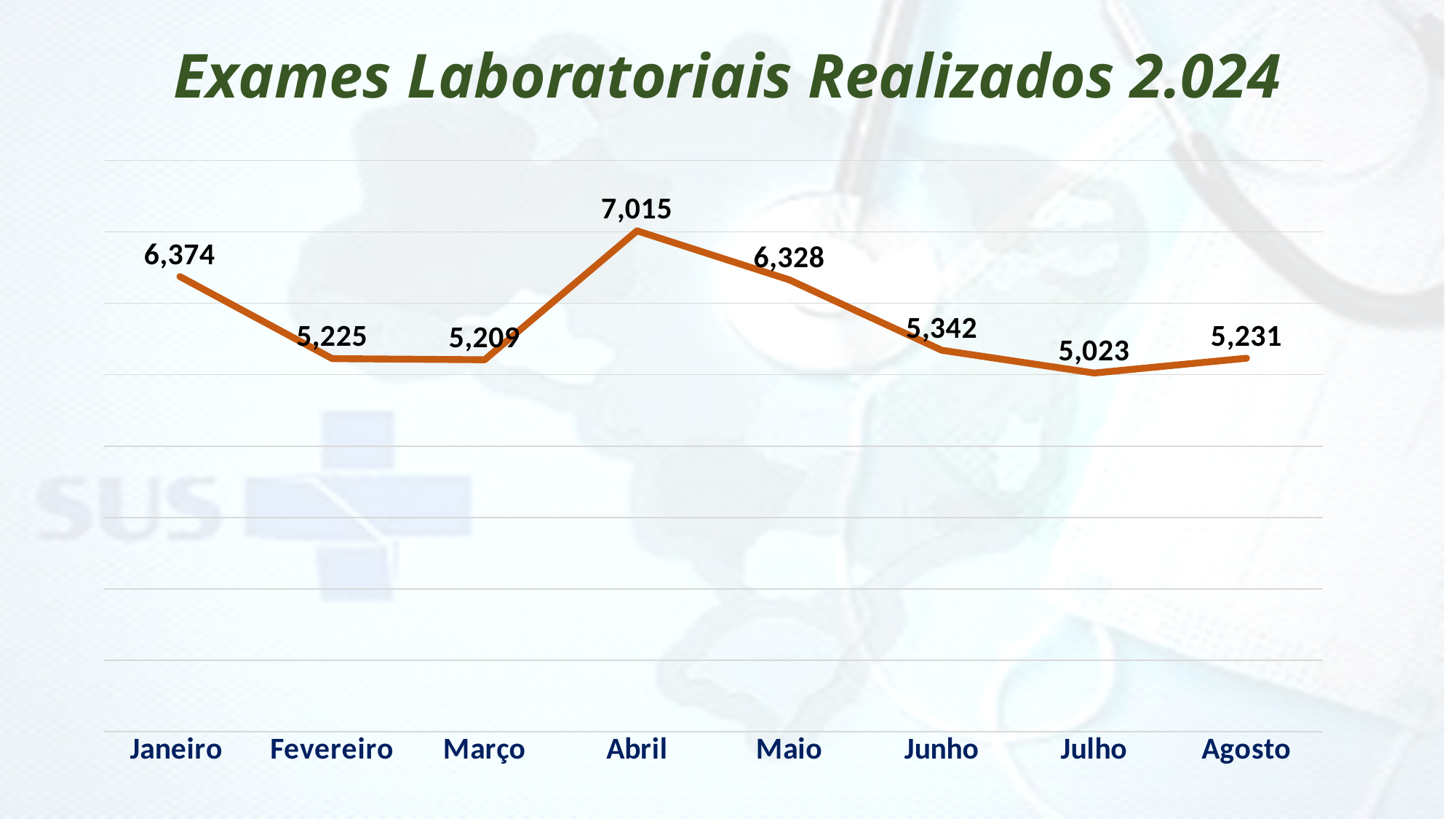
What is the value for Abril? 7,015 Which month has the highest value? Abril How many months are plotted on the chart? 8 What is the value for Janeiro? 6,374 Do the values rise or fall from Abril to Julho? Fall What is the title of the chart? Exames Laboratoriais Realizados 2.024 What is the difference between the values for Abril and Maio? 687 What is the value for Julho? 5,023 What kind of chart is shown on the slide? Line chart Which is larger, the value for Maio or the value for Junho? Maio Which month has the lowest value? Julho What is the difference between the values for Janeiro and Fevereiro? 1,149